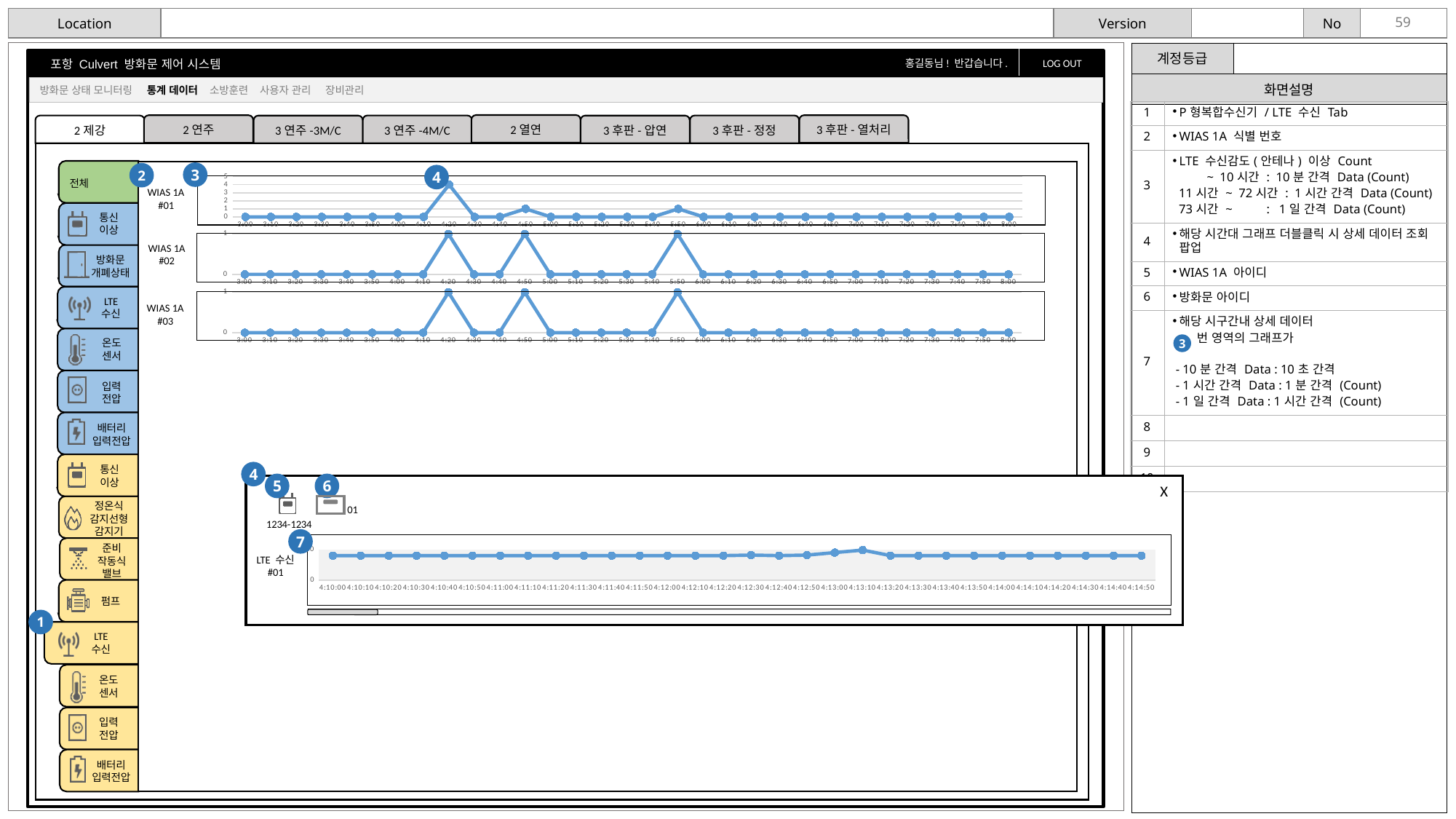
What kind of chart is used for WIAS 1A #02? line chart In the WIAS 1A #03 chart, what is the value at 7:00? 0 In the WIAS 1A #03 chart, what is the value at 5:50? 1 In the WIAS 1A #02 chart, which is larger, the value at 4:20 or the value at 4:30? 4:20 In the WIAS 1A #01 chart, at which time does the line reach its highest point? 4:20 In the WIAS 1A #01 chart, is the value at 4:20 greater or less than 3? greater In the WIAS 1A #02 chart, what is the value at 3:00? 0 How many data points are plotted in the WIAS 1A #02 chart? 31 In the WIAS 1A #01 chart, is the value at 4:50 greater or less than 3? less What is the first x-axis label on the LTE 수신 #01 chart in the popup window? 4:10:00 What is the highest tick shown on the y axis of the WIAS 1A #01 chart? 5 In the WIAS 1A #02 chart, what is the value at 4:20? 1